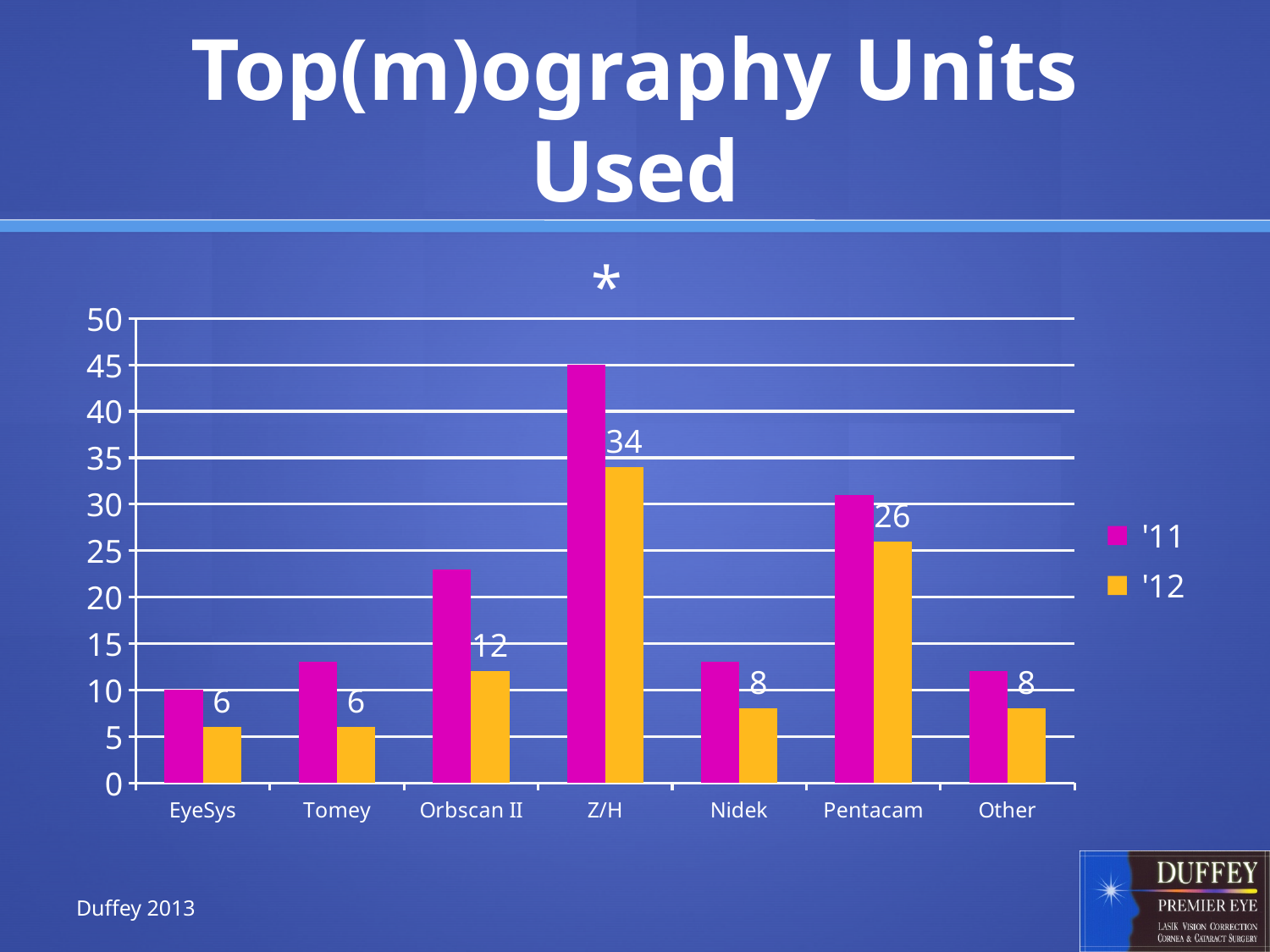
How many categories are shown on the x axis? 7 What is the '12 value for Pentacam? 26 Is the '11 value for Orbscan II greater or less than 20? greater How many series does the legend list? 2 Is the '11 value for Z/H greater or less than 40? greater Is the '11 value for Pentacam greater or less than 35? less What is the '12 value for Z/H? 34 Which category has the highest '12 value? Z/H What is the difference between the '12 values for Z/H and Pentacam? 8 What kind of chart is shown on the slide? Bar chart What is the '12 value for Orbscan II? 12 Which is larger, the '12 value for Nidek or the '12 value for Orbscan II? Orbscan II